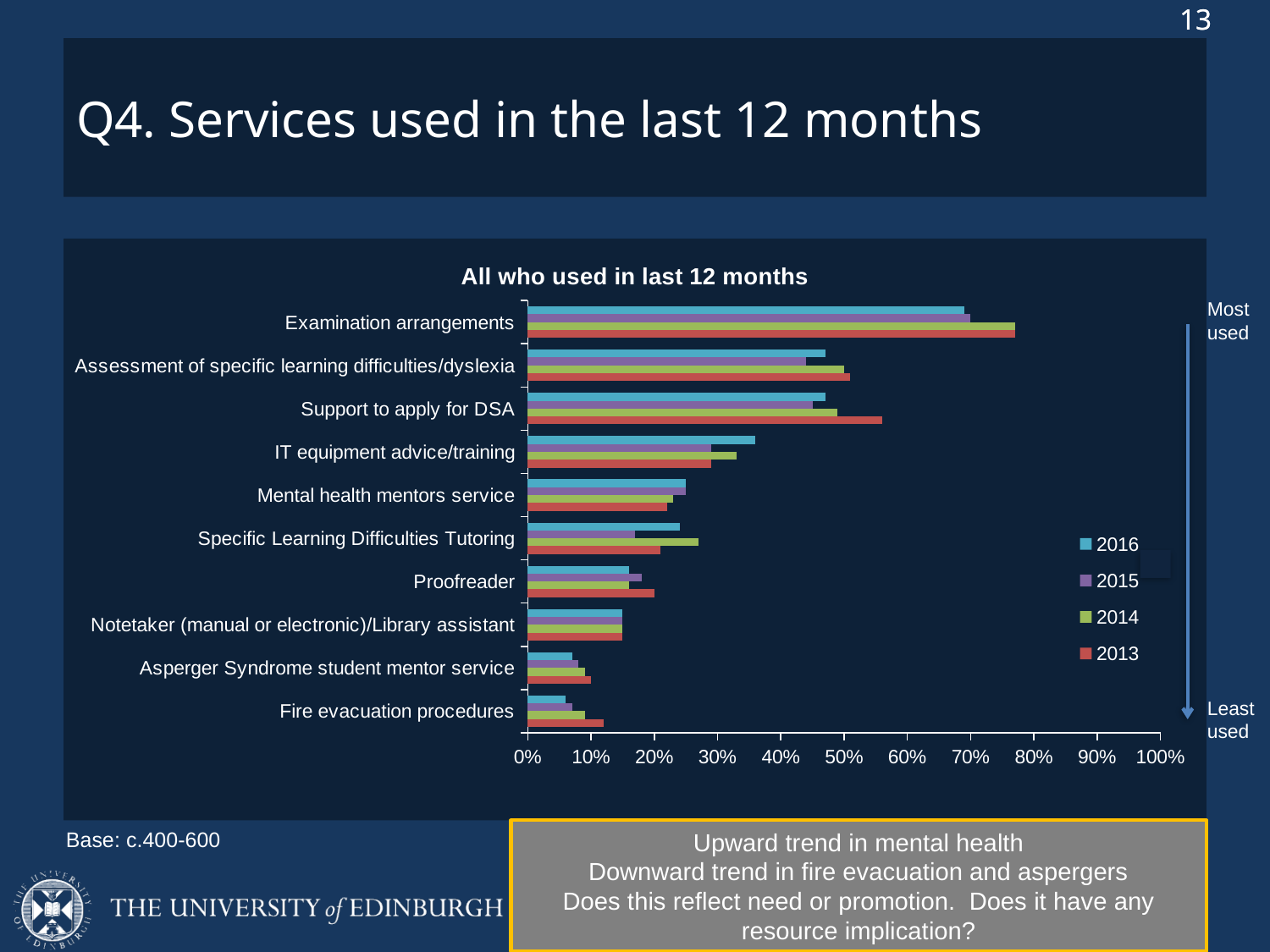
Is the 2013 value for Examination arrangements greater or less than 70%? greater How many series does the legend list? 4 What kind of chart is shown on the slide? bar chart Is the 2016 value for Mental health mentors service greater or less than 20%? greater Is the 2013 value for Support to apply for DSA greater or less than 50%? greater Which colour represents 2013 in the legend? red How many service categories are plotted on the chart? 10 Which service has the highest value for 2016? Examination arrangements For Support to apply for DSA, which year has the larger value, 2013 or 2016? 2013 For Specific Learning Difficulties Tutoring, which year has the larger value, 2014 or 2015? 2014 What is the title of the chart? All who used in last 12 months